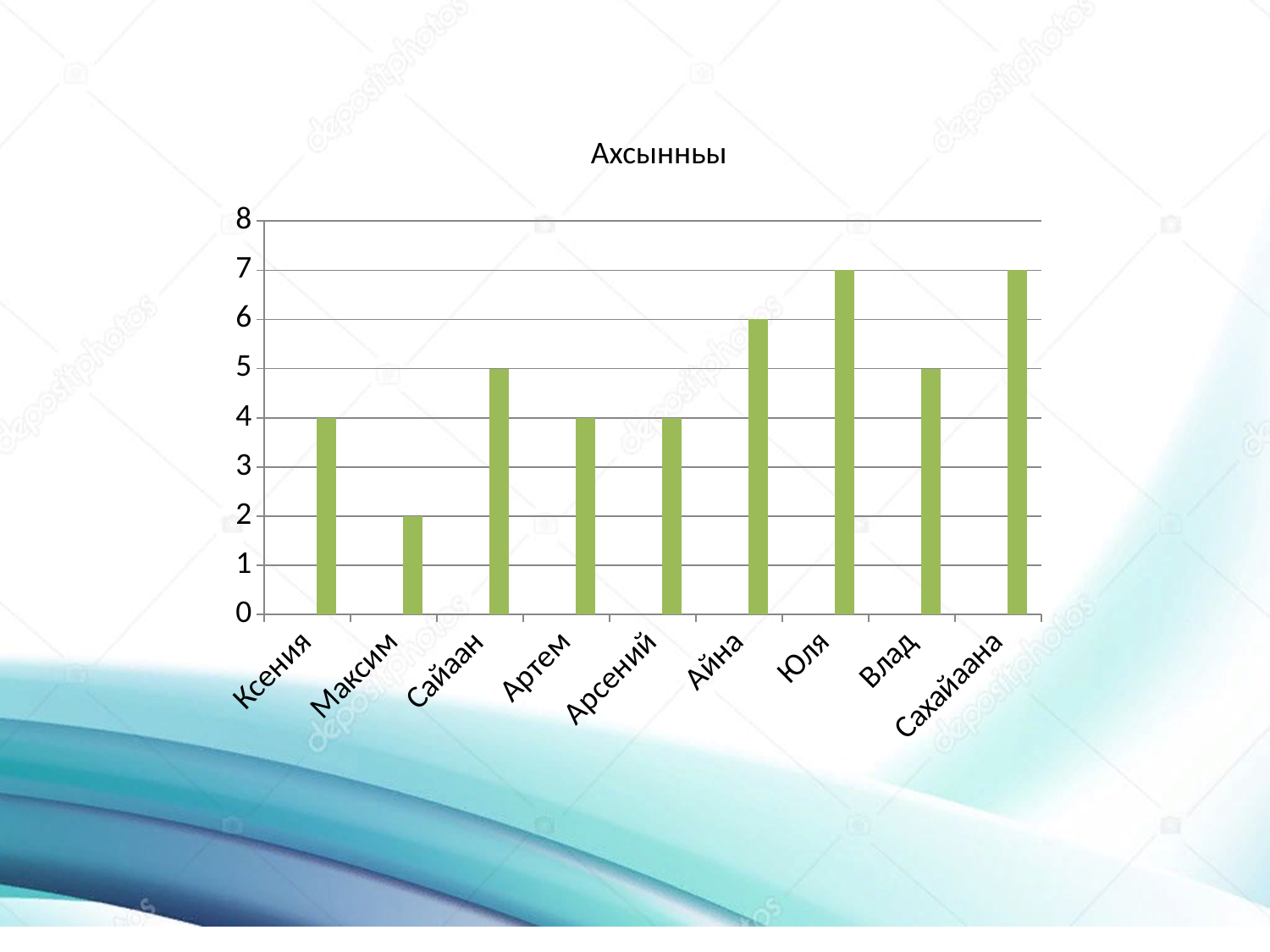
What is the value for Айна? 6 What colour are the bars in the chart? green What is the value for Сайаан? 5 What is the difference between the values for Сахайаана and Ксения? 3 How many categories are shown on the x axis of the chart? 9 Is the value for Арсений greater or less than 5? less What is the title of the chart? Ахсынньы Which category has the lowest value? Максим What type of chart is shown on the slide? bar chart What is the value for Максим? 2 What is the value for Юля? 7 Which is larger, the value for Влад or the value for Артем? Влад